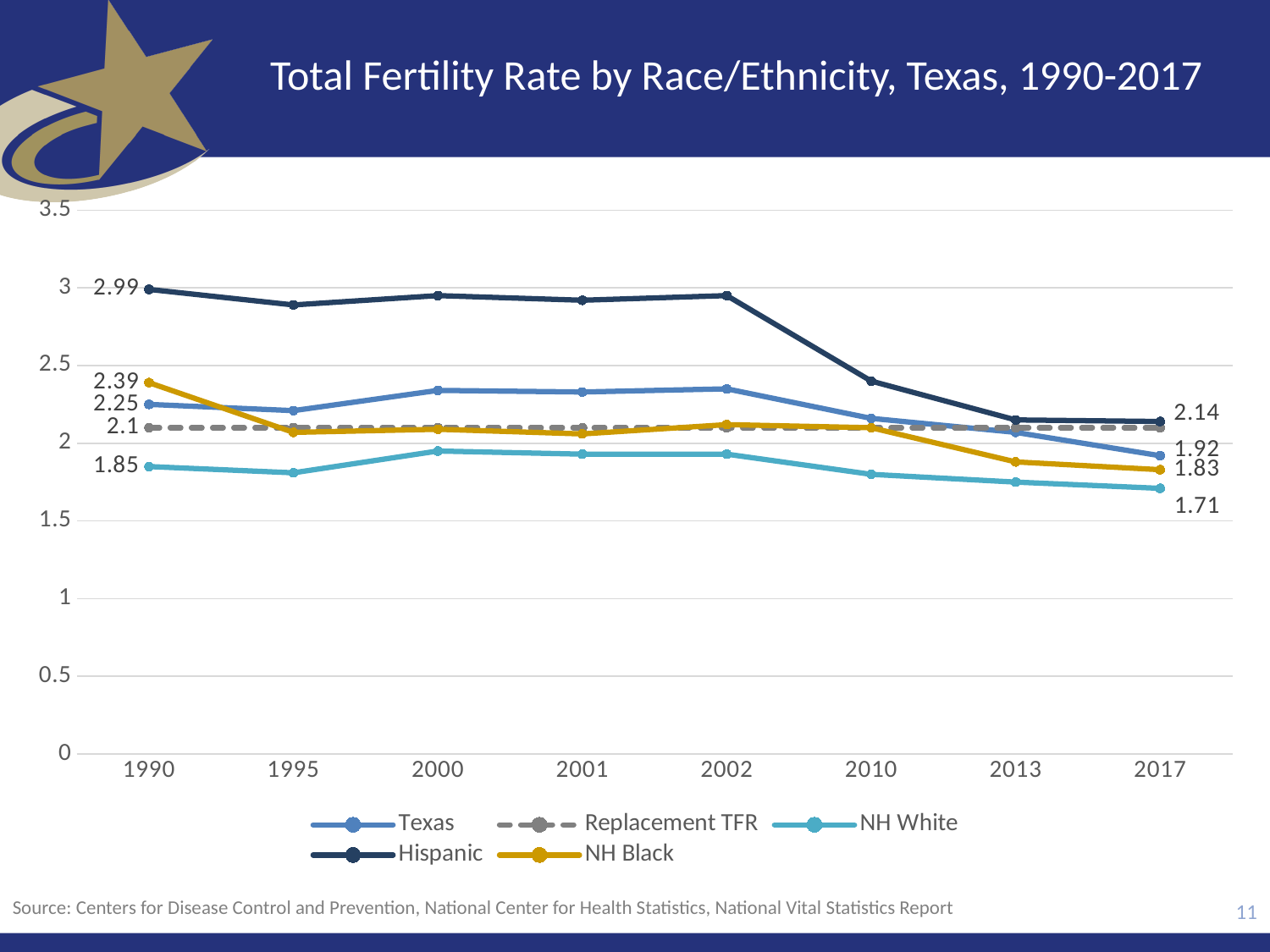
By how much did the Hispanic total fertility rate fall from 1990 (2.99) to 2017 (2.14)? 0.85 Does the Hispanic total fertility rate rise or fall between 2002 and 2017? fall What was the total fertility rate for NH Black in 1990? 2.39 Is the Hispanic value for 2010 greater or less than 2.5? less Which series had the lowest total fertility rate in 2017? NH White What kind of chart is shown on the slide? line chart How many series does the legend list? 5 How many years are shown on the x axis? 8 What was the total fertility rate for NH White in 2017? 1.71 What is the value of the Replacement TFR line? 2.1 What was the total fertility rate for Hispanic in 1990? 2.99 Which series had the highest total fertility rate in 1990? Hispanic